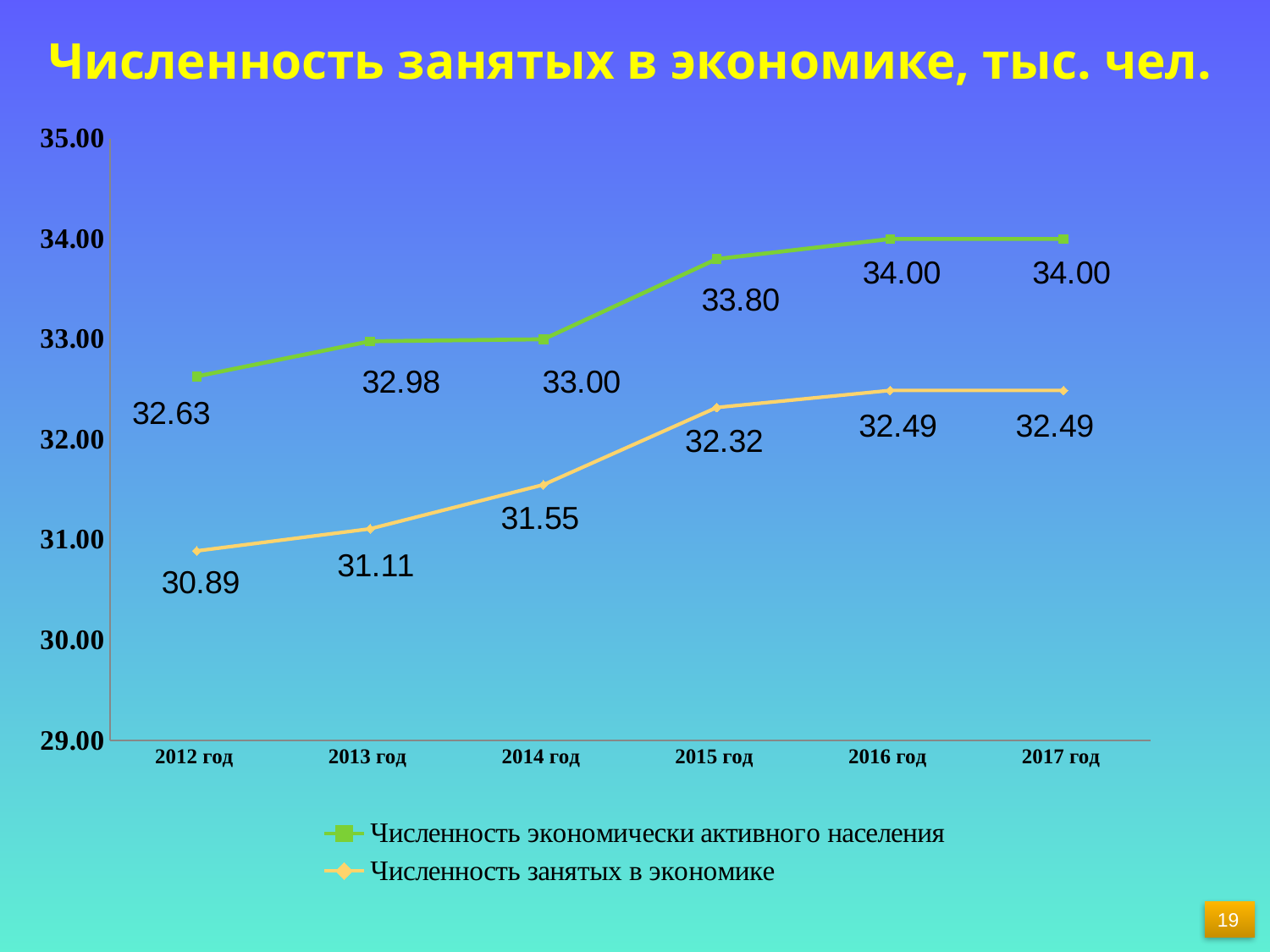
What colour is the line for 'Численность экономически активного населения'? green How many years are shown on the x axis? 6 What is the value of 'Численность занятых в экономике' for 2012 год? 30.89 Which is larger in 2013 год: 'Численность экономически активного населения' or 'Численность занятых в экономике'? Численность экономически активного населения Does 'Численность занятых в экономике' rise or fall from 2012 год to 2016 год? rise In which year is 'Численность занятых в экономике' lowest? 2012 год How many series does the legend list? 2 What is the value of 'Численность занятых в экономике' for 2014 год? 31.55 What is the value of 'Численность экономически активного населения' for 2015 год? 33.80 By how much did 'Численность занятых в экономике' increase from 2012 год to 2013 год? 0.22 What is the difference between 'Численность экономически активного населения' and 'Численность занятых в экономике' in 2017 год? 1.51 What type of chart is shown on the slide? line chart